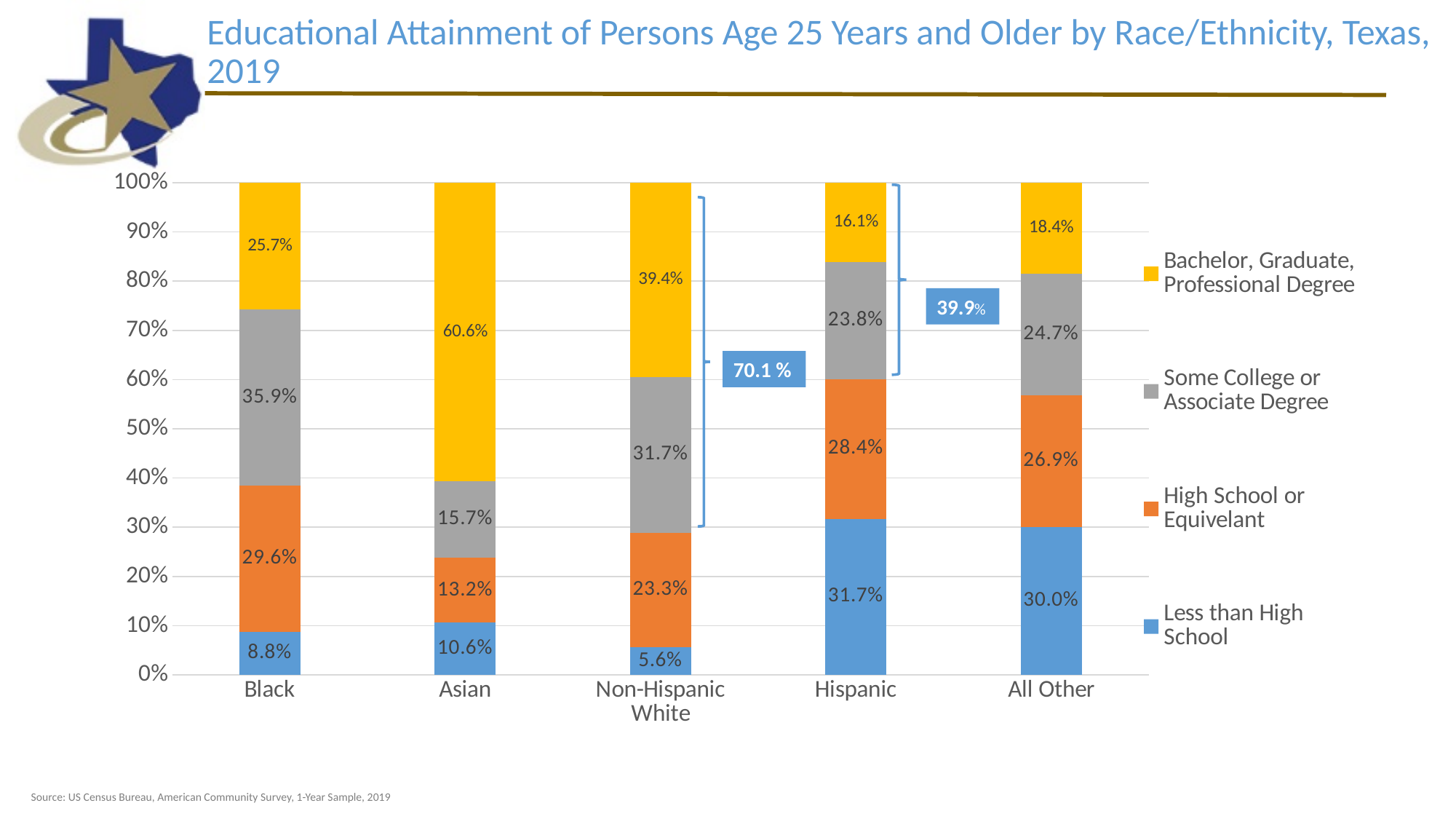
Which has a larger Some College or Associate Degree share, Black or Asian? Black Which race/ethnicity category has the lowest Less than High School share? Non-Hispanic White Which race/ethnicity category has the highest share with a Bachelor, Graduate, or Professional Degree? Asian What percentage of Asian persons age 25 and older have a Bachelor, Graduate, or Professional Degree? 60.6% How many race/ethnicity categories are shown on the x axis? 5 What is the High School or Equivelant value for the Black category? 29.6% What is the difference in percentage points between the Less than High School share for Hispanic and for Black? 22.9 percentage points What is the Some College or Associate Degree value for All Other? 24.7% What is the Less than High School value for the Hispanic category? 31.7% What kind of chart is shown on the slide? Stacked bar chart How many series does the legend list? 4 Which colour represents the Less than High School series? Blue